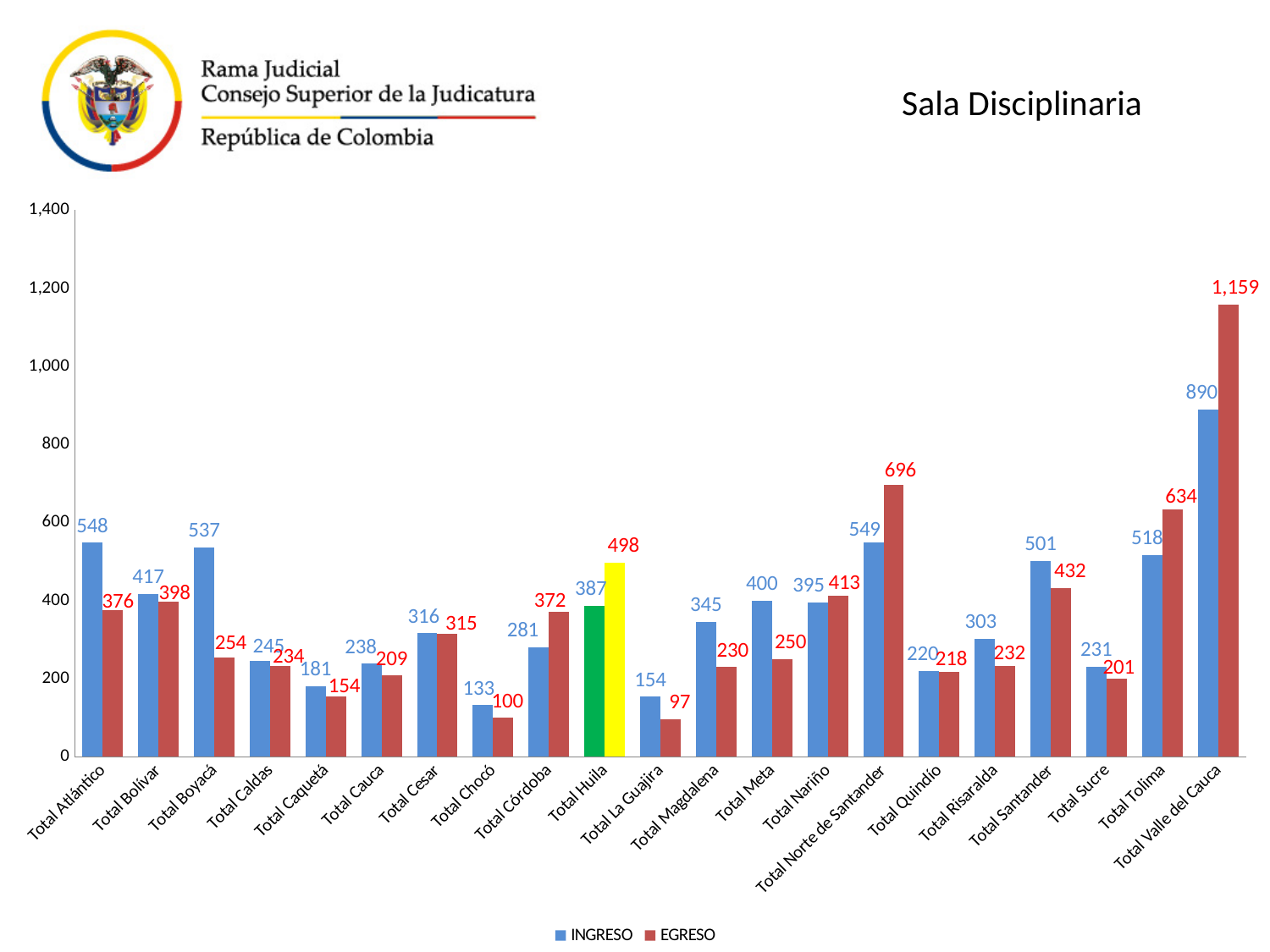
Which is larger for Total Tolima, INGRESO or EGRESO? EGRESO What is the INGRESO value for Total Valle del Cauca? 890 How many categories are shown on the x axis? 21 How many series does the legend list? 2 What is the difference between the EGRESO and INGRESO values for Total Valle del Cauca? 269 What kind of chart is shown on the slide? Bar chart Is the INGRESO value for Total Atlántico greater or less than 400? greater What is the EGRESO value for Total Norte de Santander? 696 What are the two series named in the legend? INGRESO and EGRESO Which category has the lowest INGRESO value? Total Chocó Which category has the highest EGRESO value? Total Valle del Cauca What is the EGRESO value for Total Huila? 498